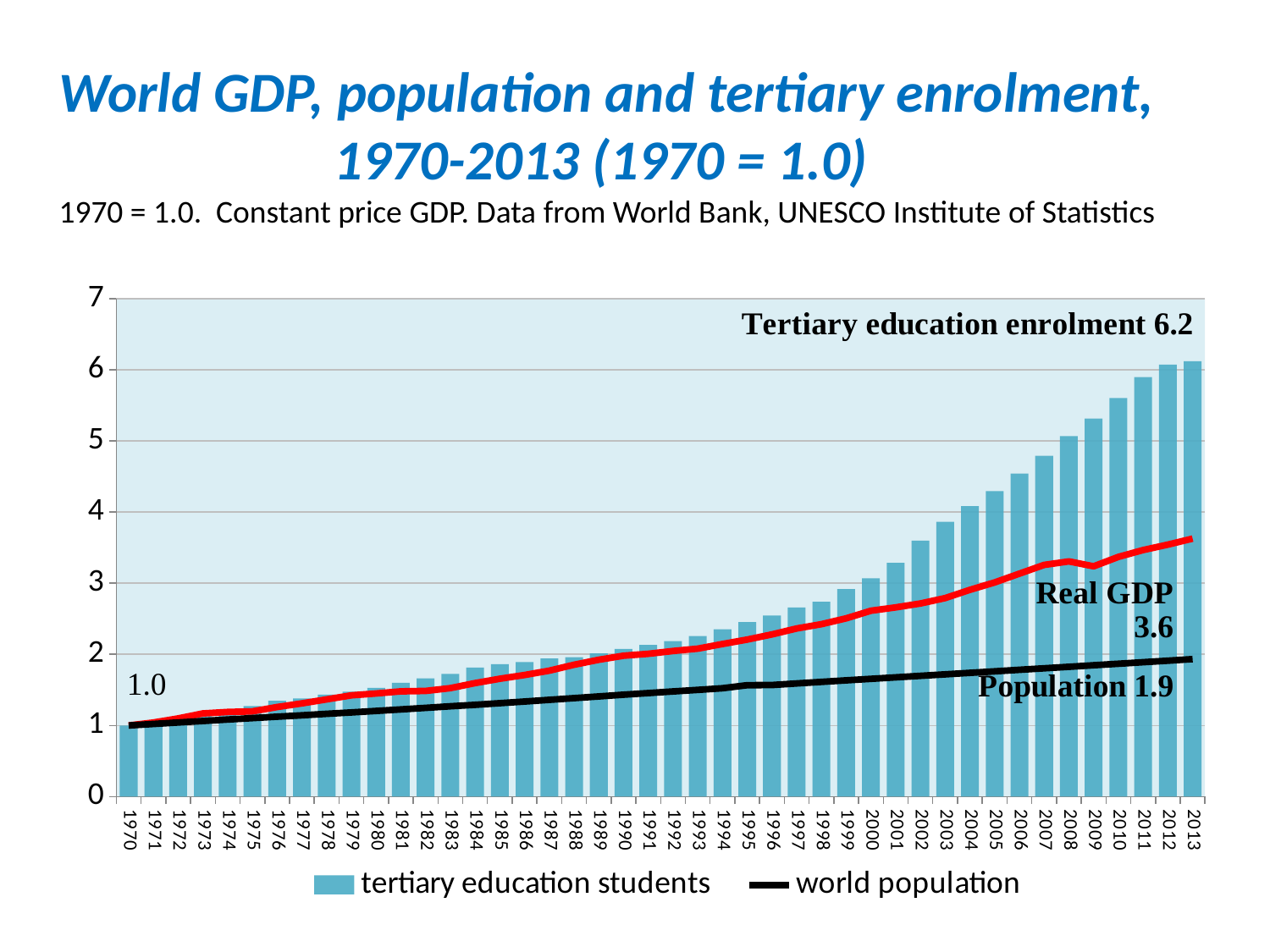
What is the tertiary education enrolment index value shown for 2013? 6.2 Do the tertiary education students bars rise or fall from 1970 to 2013? Rise What value is labelled at the start of the series in 1970? 1.0 Is the tertiary education students bar for 2005 greater or less than 4? greater How many series does the legend list? 2 Which is larger in 2013: tertiary education enrolment or Real GDP? Tertiary education enrolment By how much does the 2013 tertiary education enrolment value (6.2) exceed the 2013 population value (1.9)? 4.3 What is the world population index value labelled at the end of the black line? 1.9 What is the Real GDP index value labelled at the end of the red line? 3.6 What is the difference between the Real GDP value (3.6) and the Population value (1.9) labelled on the chart? 1.7 How many years are shown on the x axis? 44 Is the tertiary education students bar for 1980 greater or less than 2? less